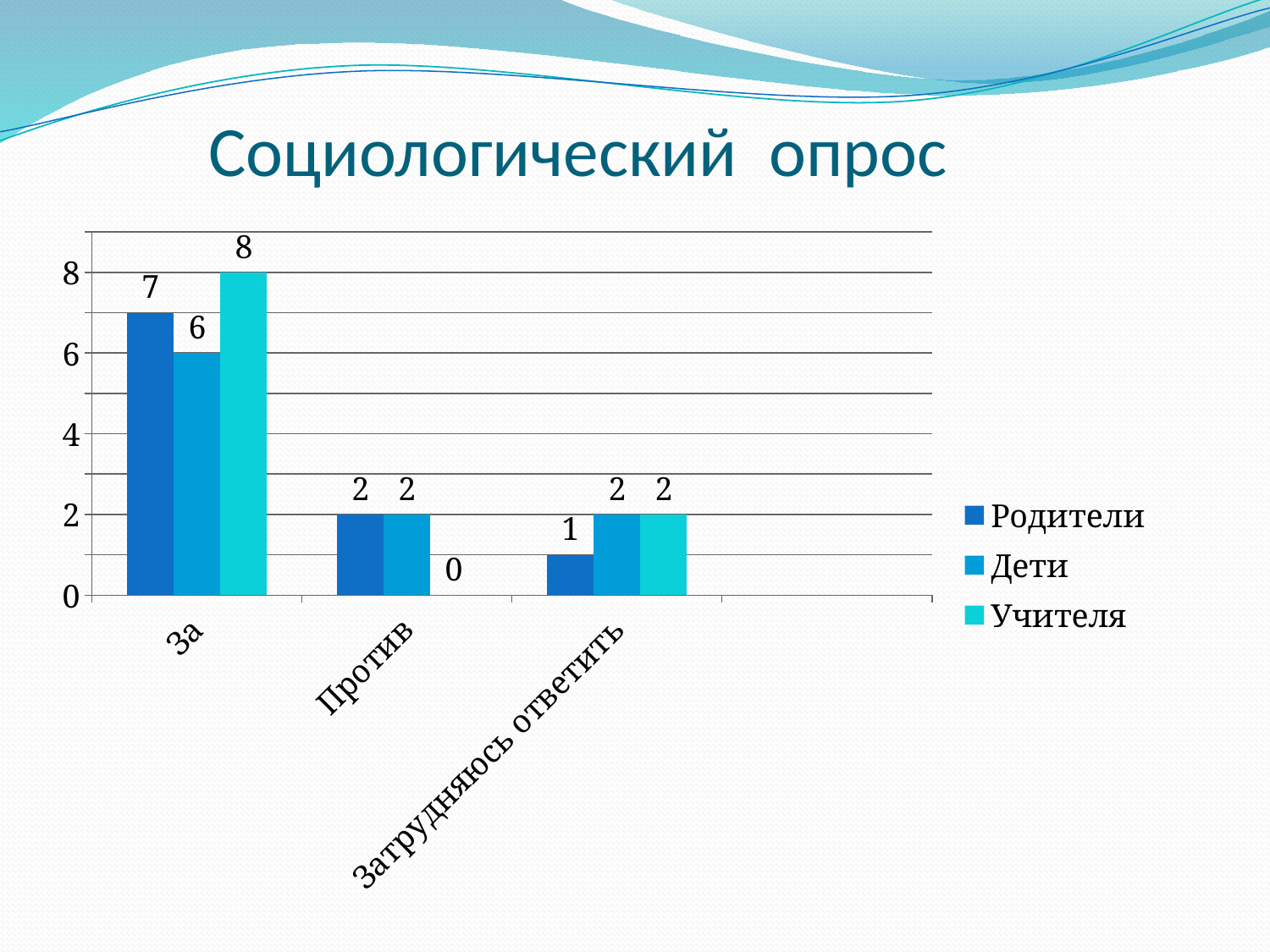
What is the value for Учителя in the Против category? 0 What is the value for Родители in the Затрудняюсь ответить category? 1 What kind of chart is shown on the slide? Bar chart Which series has the lowest value in the Против category? Учителя How many categories are shown on the x axis? 3 What is the title of the slide? Социологический опрос What is the value for Учителя in the За category? 8 What is the difference between the Учителя and Дети values in the За category? 2 What is the value for Родители in the За category? 7 Which series has the highest value in the За category? Учителя How many series does the legend list? 3 Which is larger: the Родители value for За or the Родители value for Против? За